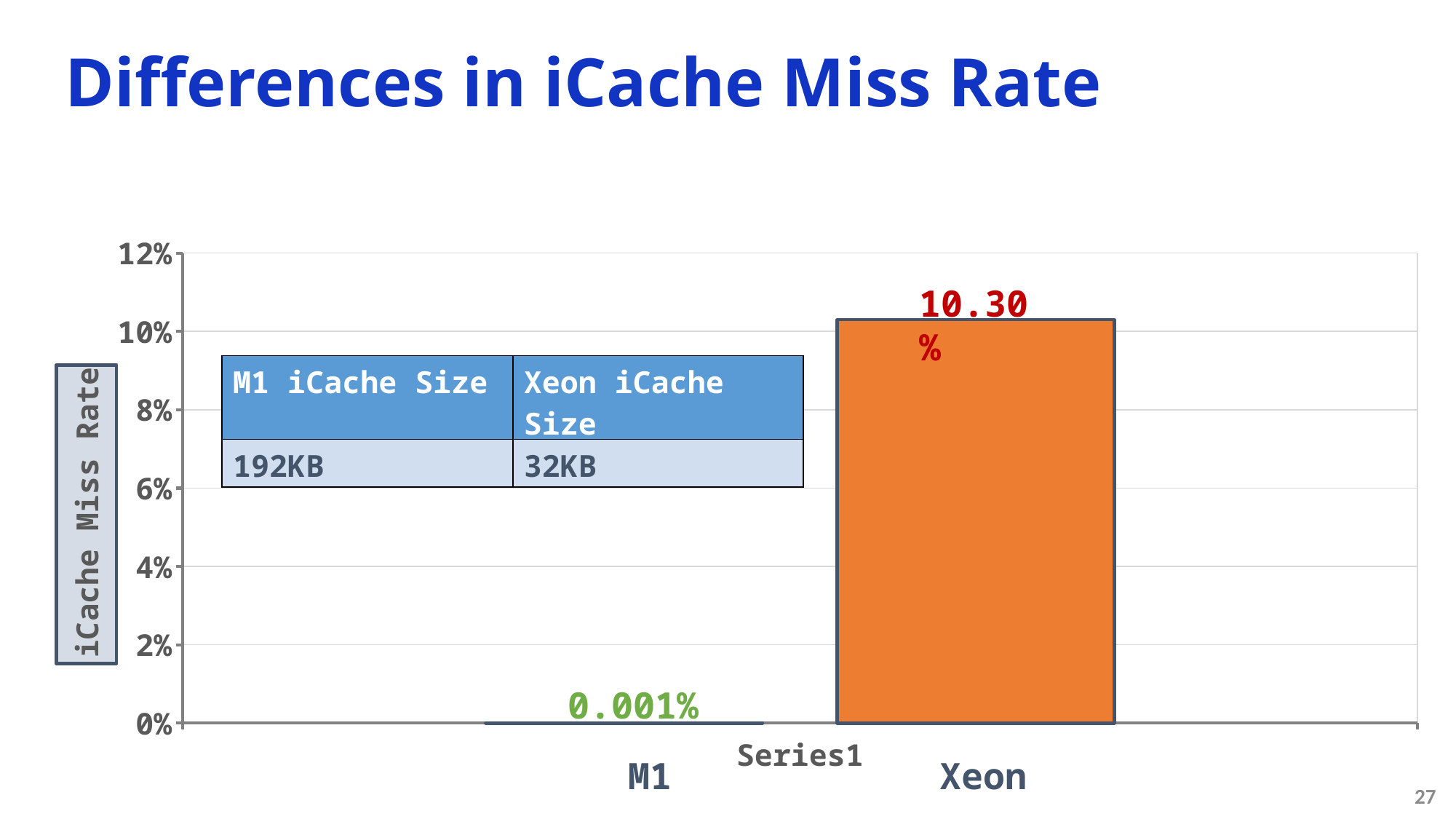
Is the iCache miss rate for Xeon greater or less than 10%? greater Is the Xeon bar larger or smaller than the M1 bar? larger What is the highest value shown on the vertical axis? 12% Which processor has the lower iCache miss rate? M1 How many processors are plotted on the chart? 2 What is the iCache miss rate shown for Xeon? 10.30% What is the difference between the Xeon and M1 iCache miss rates? 10.30% Is the iCache miss rate for M1 greater or less than 2%? less What kind of chart is shown on the slide? bar chart What is the label on the vertical axis of the chart? iCache Miss Rate What is the iCache miss rate shown for M1? 0.001% Which processor has the higher iCache miss rate? Xeon